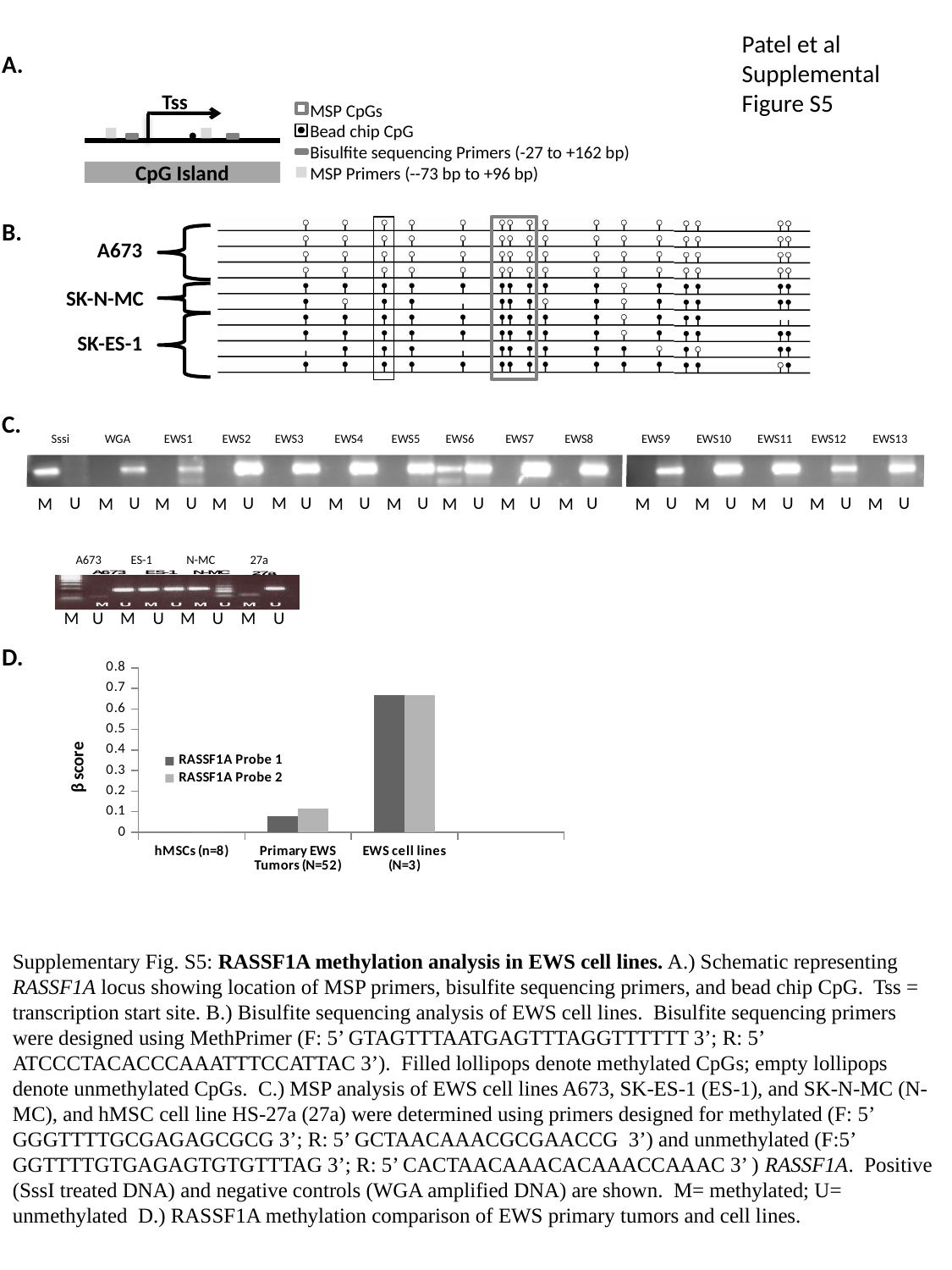
In panel D, what kind of chart is shown? bar chart In panel D, is the RASSF1A Probe 1 value for EWS cell lines (N=3) greater or less than 0.6? greater In panel D, is the RASSF1A Probe 2 value for Primary EWS Tumors (N=52) greater or less than 0.3? less In panel D, what is the label of the y axis? β score In panel D, how many series does the legend list? 2 In panel D, which category has the highest β score for RASSF1A Probe 1? EWS cell lines (N=3) In panel D, is the RASSF1A Probe 1 value for Primary EWS Tumors (N=52) greater or less than 0.2? less In panel D, what are the two legend entries? RASSF1A Probe 1 and RASSF1A Probe 2 In panel D, which category has the lowest β score for RASSF1A Probe 2? hMSCs (n=8) In panel D, which is larger for RASSF1A Probe 2: Primary EWS Tumors (N=52) or EWS cell lines (N=3)? EWS cell lines (N=3) In panel D, do the β scores rise or fall moving from hMSCs (n=8) to EWS cell lines (N=3) along the x axis? rise In panel D, how many categories are shown on the x axis? 3